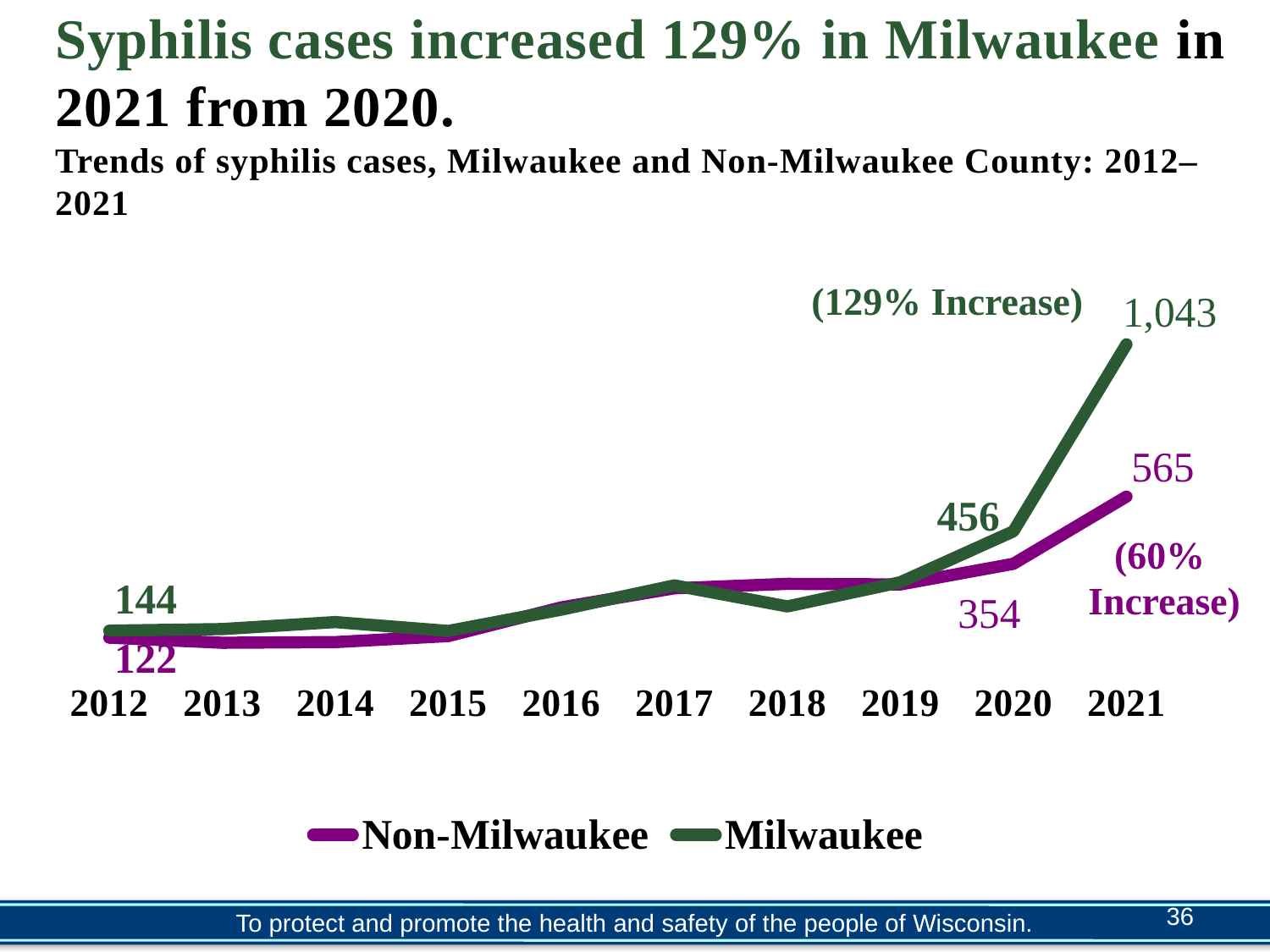
Which series had more syphilis cases in 2021, Milwaukee or Non-Milwaukee? Milwaukee What was the number of syphilis cases in Milwaukee in 2020? 456 What was the number of syphilis cases for Non-Milwaukee in 2021? 565 What was the number of syphilis cases in Milwaukee in 2021? 1,043 How many series does the legend list? 2 What was the number of syphilis cases for Non-Milwaukee in 2020? 354 In which year did Milwaukee have its highest number of syphilis cases? 2021 What percentage increase is annotated for the Non-Milwaukee series? 60% Increase What is the difference between Milwaukee and Non-Milwaukee syphilis cases in 2021? 478 What was the number of syphilis cases in Milwaukee in 2012? 144 What type of chart is shown on the slide? Line chart How many years are shown on the x axis? 10